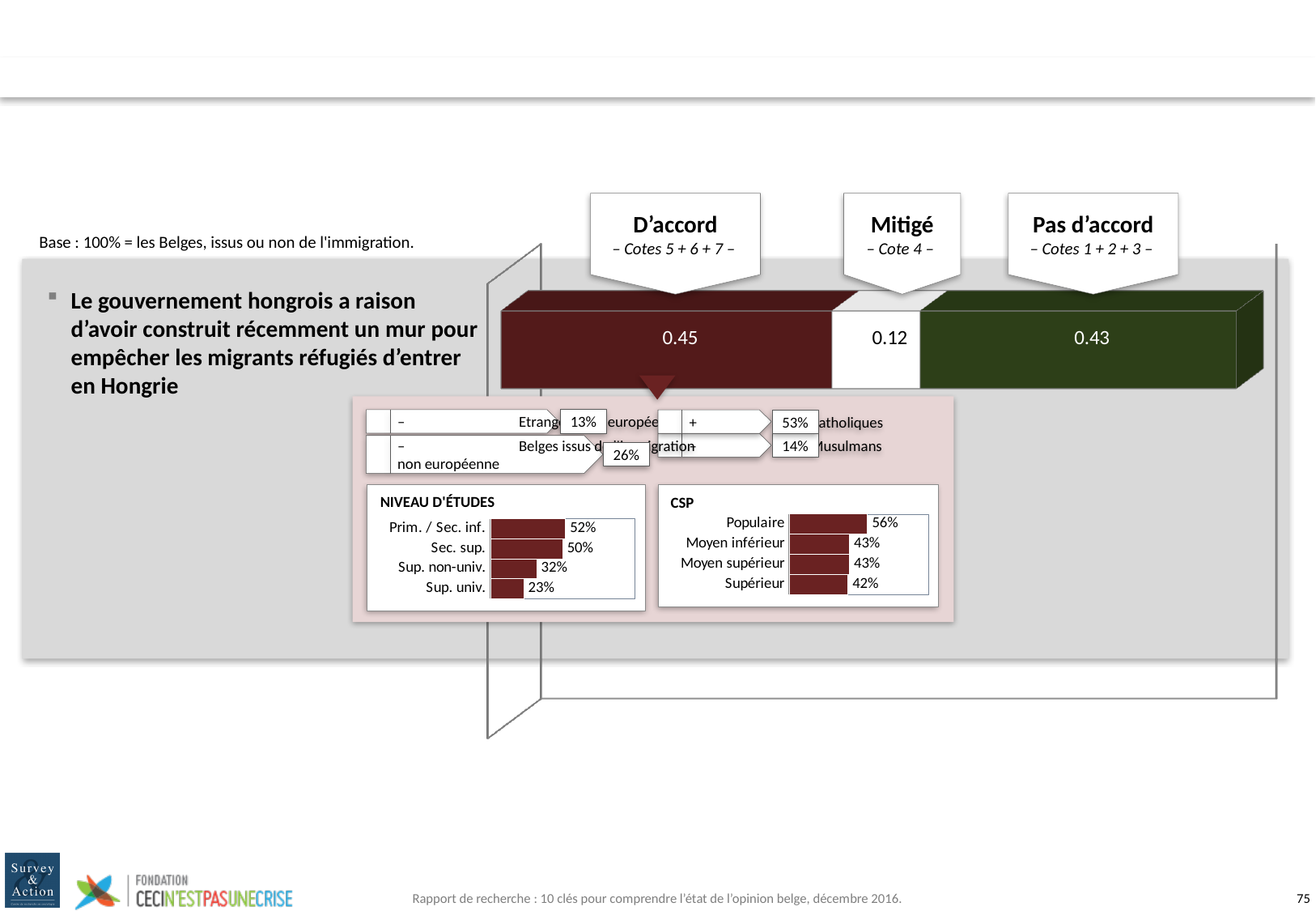
In the 'NIVEAU D'ÉTUDES' chart, what is the difference between 'Sec. sup.' and 'Sup. non-univ.'? 18% In the 'NIVEAU D'ÉTUDES' chart, what is the value for 'Sup. univ.'? 23% In the main stacked bar chart, what is the value for 'Pas d'accord'? 0.43 In the main stacked bar chart, what is the difference between 'D'accord' and 'Pas d'accord'? 0.02 In the 'NIVEAU D'ÉTUDES' chart, which category has the highest value? Prim. / Sec. inf. In the 'NIVEAU D'ÉTUDES' chart, how many categories are shown? 4 In the 'CSP' chart, which category has the lowest value? Supérieur In the main stacked bar chart, which segment is the smallest? Mitigé What kind of chart is the 'CSP' chart? Bar chart In the main stacked bar chart, what is the value for 'D'accord'? 0.45 In the main stacked bar chart, what is the value for 'Mitigé'? 0.12 In the 'CSP' chart, what is the value for 'Populaire'? 56%